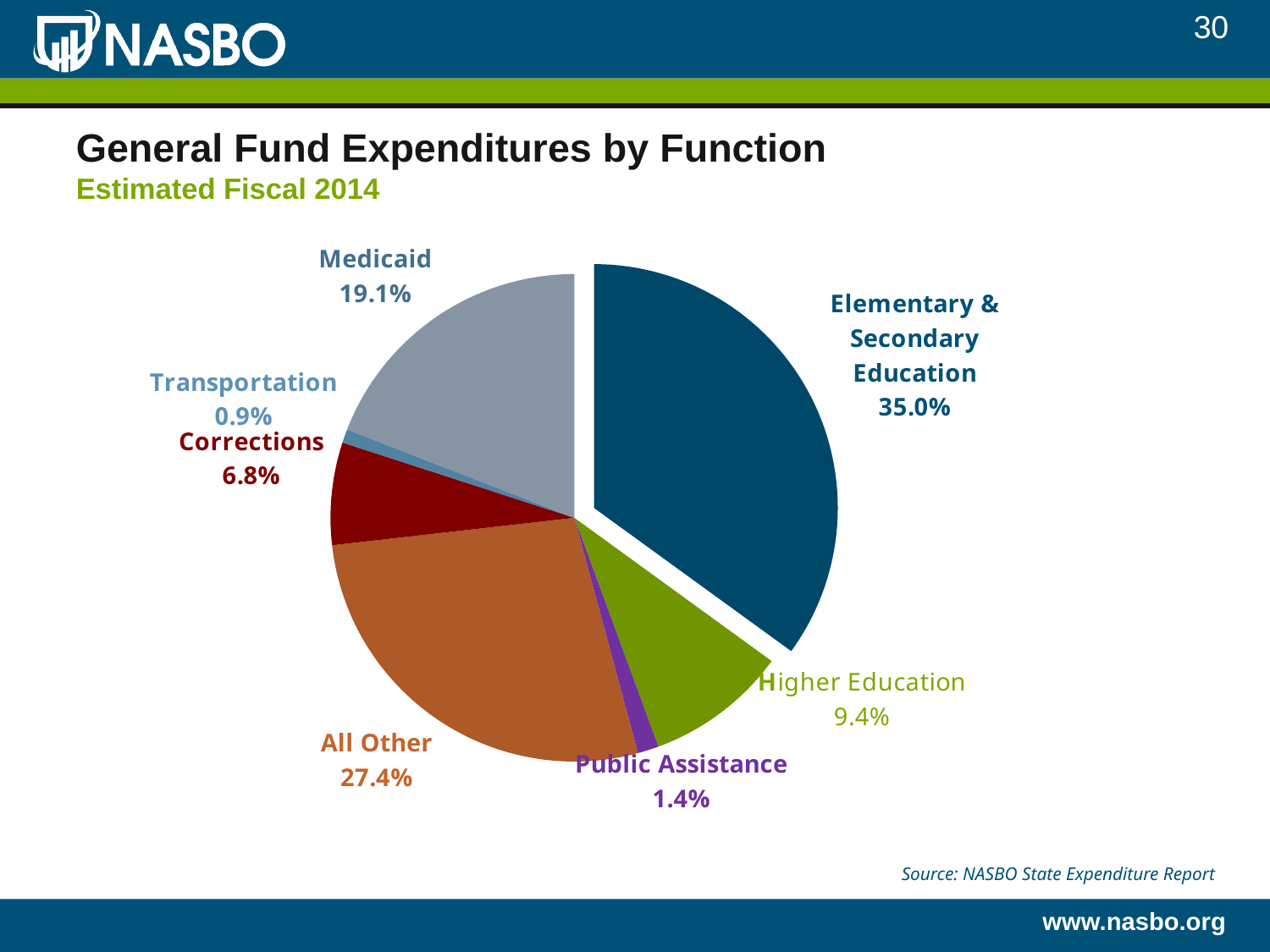
What is the value shown for Higher Education? 9.4% Which is larger, the share for Medicaid or the share for Higher Education? Medicaid What is the value for Public Assistance? 1.4% What percentage is shown for Corrections? 6.8% Which category has the largest share of the pie? Elementary & Secondary Education What fiscal year does the chart's subtitle refer to? Estimated Fiscal 2014 How many categories are shown in the pie chart? 7 What share of general fund expenditures goes to Medicaid? 19.1% What kind of chart is shown on the slide? pie chart What is the combined share of Medicaid and Corrections? 25.9% What is the difference between the shares for Elementary & Secondary Education and All Other? 7.6% Which category has the smallest share of the pie? Transportation